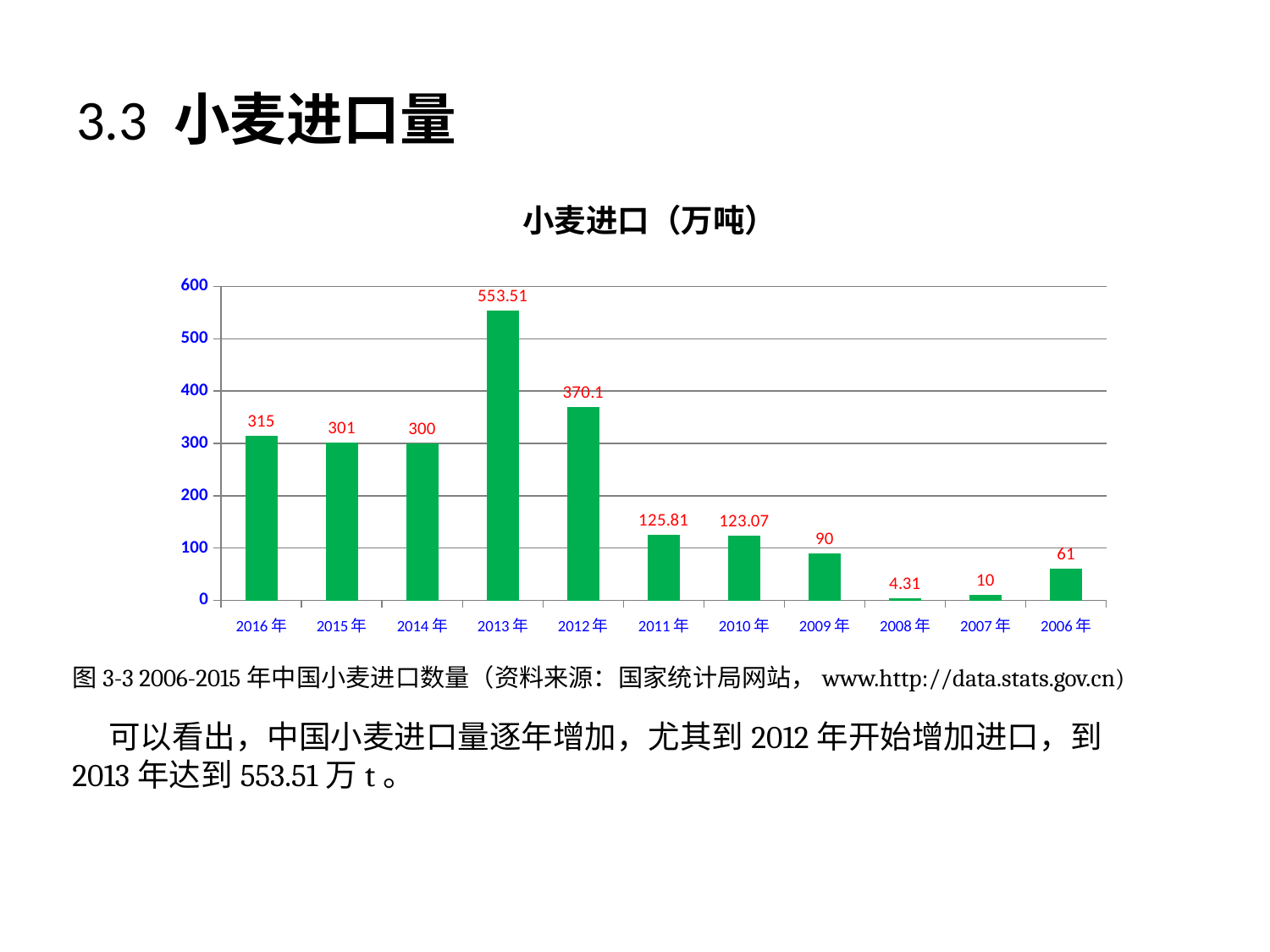
What is the difference between the wheat import values for 2013年 and 2012年? 183.41 What colour are the bars in the chart? green What is the wheat import value for 2013年? 553.51 What is the title of the chart? 小麦进口（万吨） Which year has the highest wheat import value? 2013年 Is the value for 2009年 greater or less than 100? less What is the wheat import value for 2016年? 315 What kind of chart is shown on the slide? bar chart What is the wheat import value for 2008年? 4.31 Which is larger, the wheat import value for 2011年 or 2010年? 2011年 How many years are shown on the x axis? 11 Which year has the lowest wheat import value? 2008年